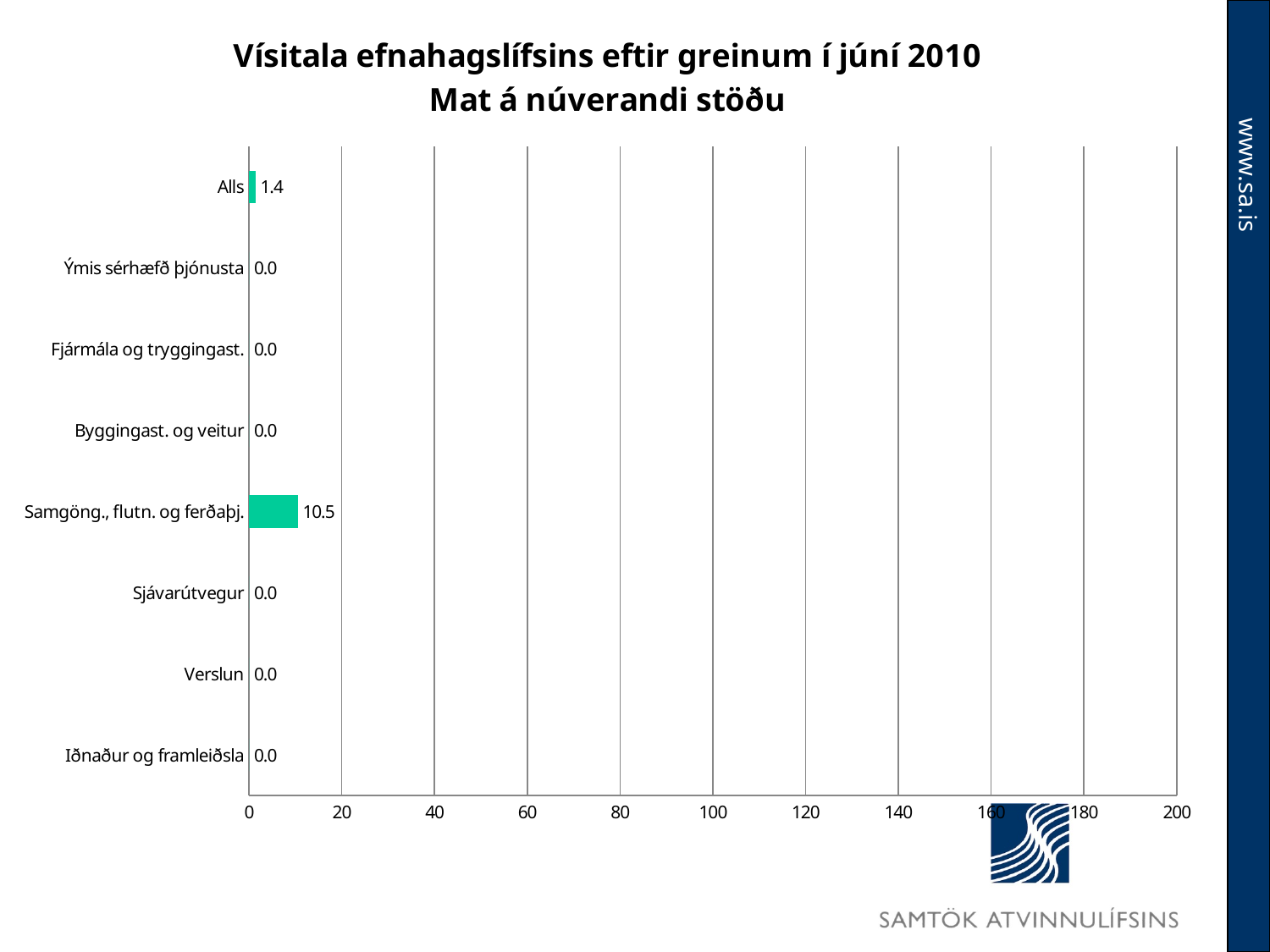
What kind of chart is shown on the slide? bar chart How many categories are shown on the chart? 8 What is the difference between the values for Samgöng., flutn. og ferðaþj. and Alls? 9.1 What is the maximum value shown on the x axis? 200 How many categories have a value of 0.0? 6 Is the value for Samgöng., flutn. og ferðaþj. greater or less than 20? less What is the value for Alls? 1.4 What is the value for Samgöng., flutn. og ferðaþj.? 10.5 Which category has the highest value? Samgöng., flutn. og ferðaþj. What is the value for Sjávarútvegur? 0.0 What is the value for Verslun? 0.0 Which is larger, the value for Samgöng., flutn. og ferðaþj. or the value for Alls? Samgöng., flutn. og ferðaþj.